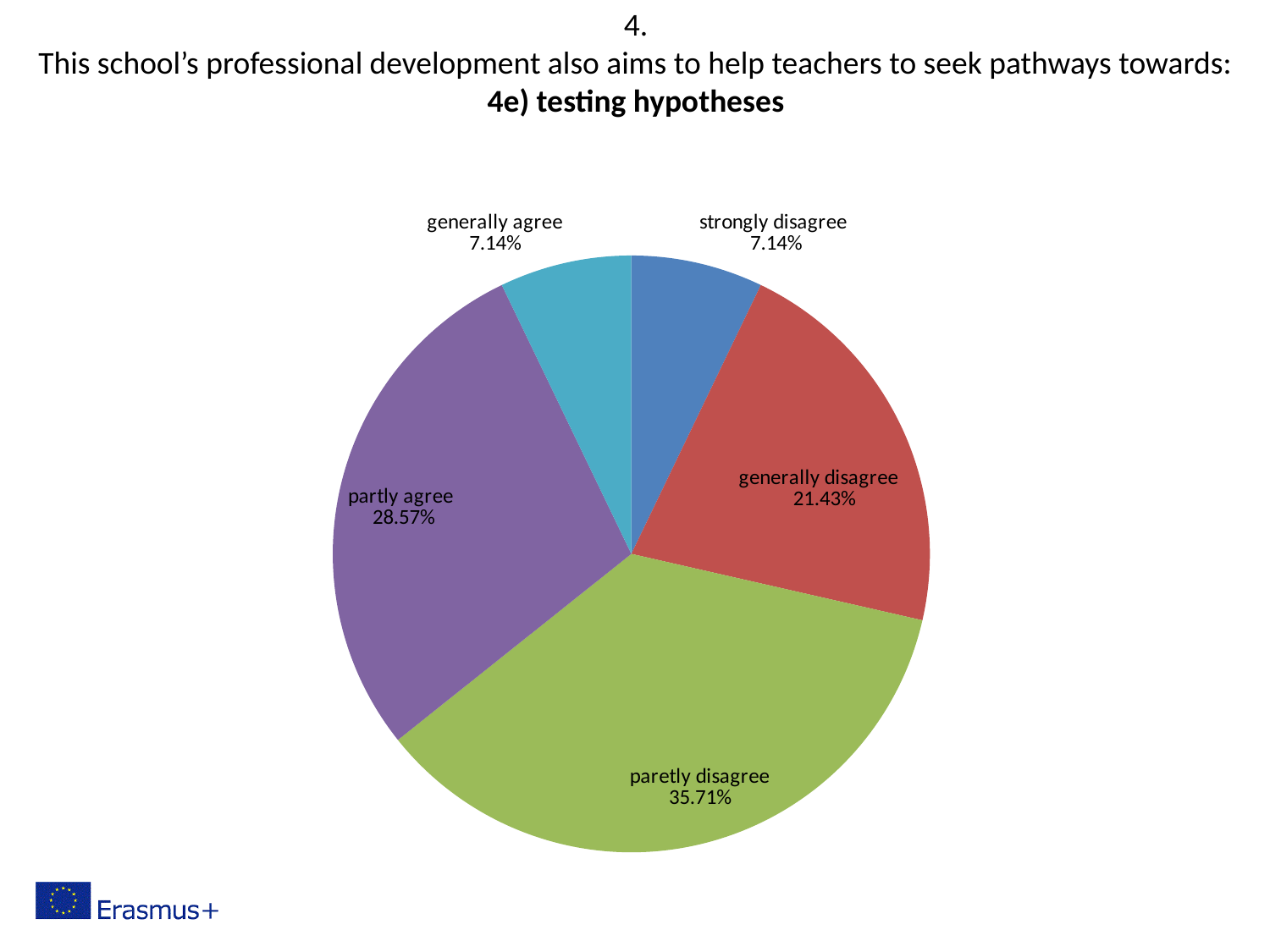
What is the difference in percentage points between 'generally disagree' and 'strongly disagree'? 14.29 What is the bold subtitle of the chart on the slide? 4e) testing hypotheses What share of the pie is labelled 'strongly disagree'? 7.14% What share of the pie is labelled 'partly agree'? 28.57% Which category has the largest slice of the pie? paretly disagree What is the difference in percentage points between 'paretly disagree' and 'partly agree'? 7.14 What share of the pie is labelled 'paretly disagree'? 35.71% How many slices does the pie chart have? 5 What kind of chart is shown on the slide? pie chart Which is larger, the 'generally disagree' slice or the 'partly agree' slice? partly agree